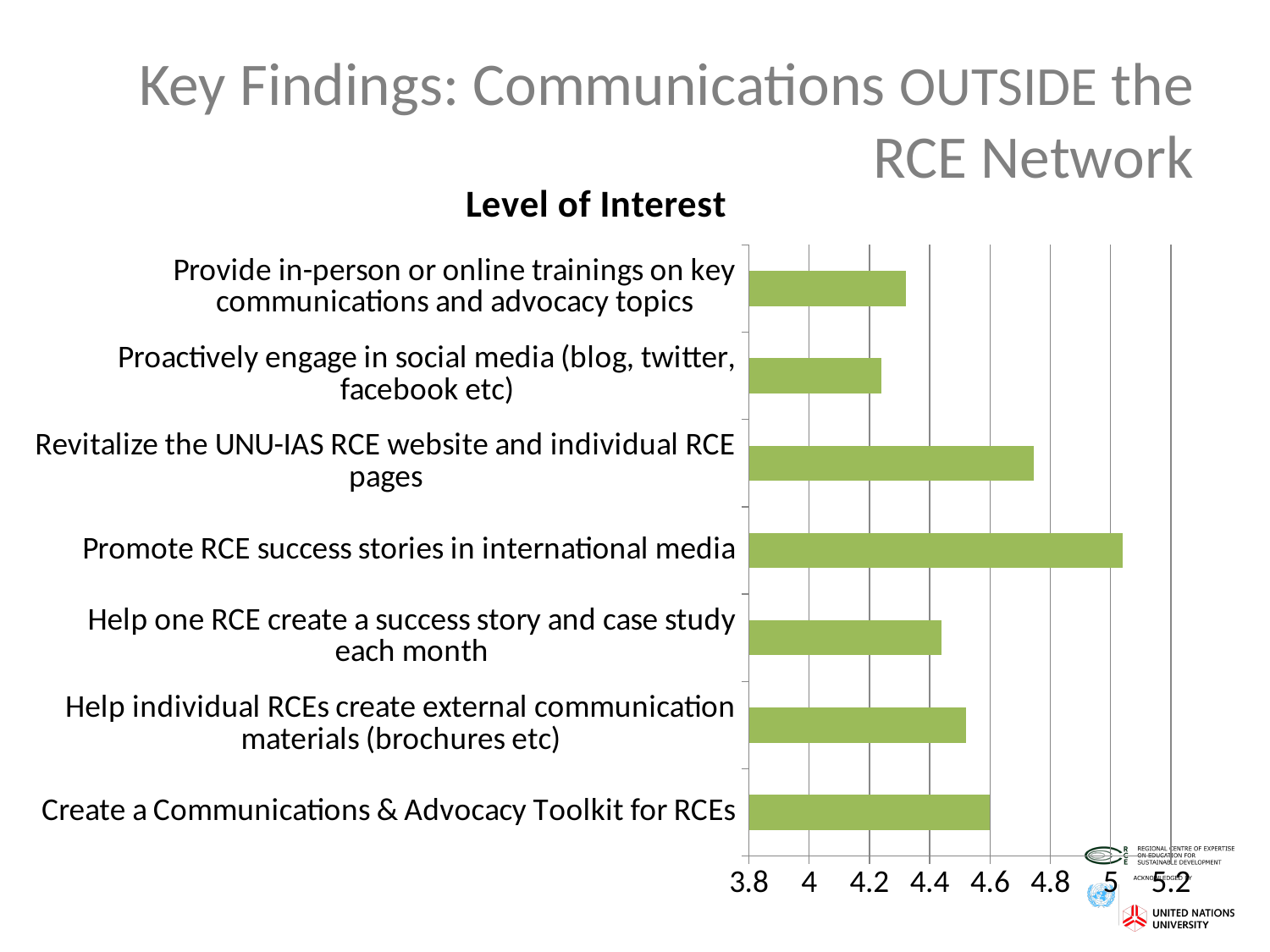
Which has a higher level of interest: 'Revitalize the UNU-IAS RCE website and individual RCE pages' or 'Help one RCE create a success story and case study each month'? Revitalize the UNU-IAS RCE website and individual RCE pages Is the value for 'Provide in-person or online trainings on key communications and advocacy topics' greater or less than 4.2? greater Is the value for 'Help individual RCEs create external communication materials (brochures etc)' greater or less than 4.4? greater Is the value for 'Promote RCE success stories in international media' greater or less than 5? greater What is the title of the chart? Level of Interest How many categories are plotted in the chart? 7 What kind of chart is shown on the slide? bar chart Which category has the highest level of interest? Promote RCE success stories in international media Which category has the lowest level of interest? Proactively engage in social media (blog, twitter, facebook etc) What colour are the bars in the chart? green